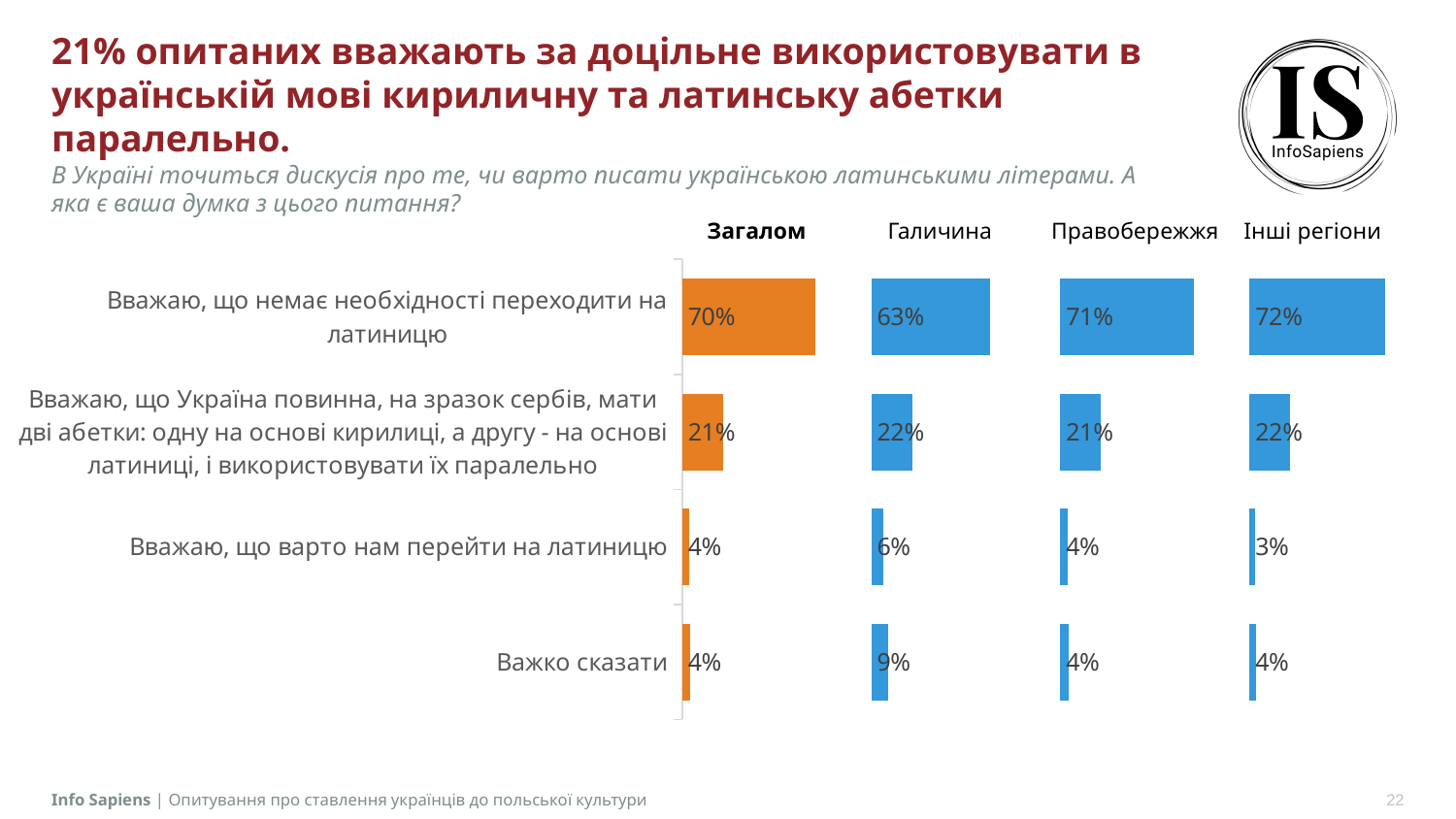
What is the difference between the Інші регіони value and the Галичина value for "Вважаю, що немає необхідності переходити на латиницю"? 9% In the Галичина chart, which category has the highest value? Вважаю, що немає необхідності переходити на латиницю In the Загалом chart, what is the difference between the top category (70%) and the second category (21%)? 49% In the Галичина chart, what is the value for "Важко сказати"? 9% In the Правобережжя chart, what is the value for "Вважаю, що Україна повинна, на зразок сербів, мати дві абетки..."? 21% For "Вважаю, що варто нам перейти на латиницю", which is larger: the Галичина value or the Правобережжя value? Галичина In the Інші регіони chart, which category has the lowest value? Вважаю, що варто нам перейти на латиницю In the Інші регіони chart, what is the value for "Вважаю, що варто нам перейти на латиницю"? 3% What colour are the bars in the Загалом chart? Orange How many categories are shown in the Загалом chart? 4 In the Загалом chart, what is the value for "Вважаю, що немає необхідності переходити на латиницю"? 70% What kind of chart is used for the Загалом column? Bar chart